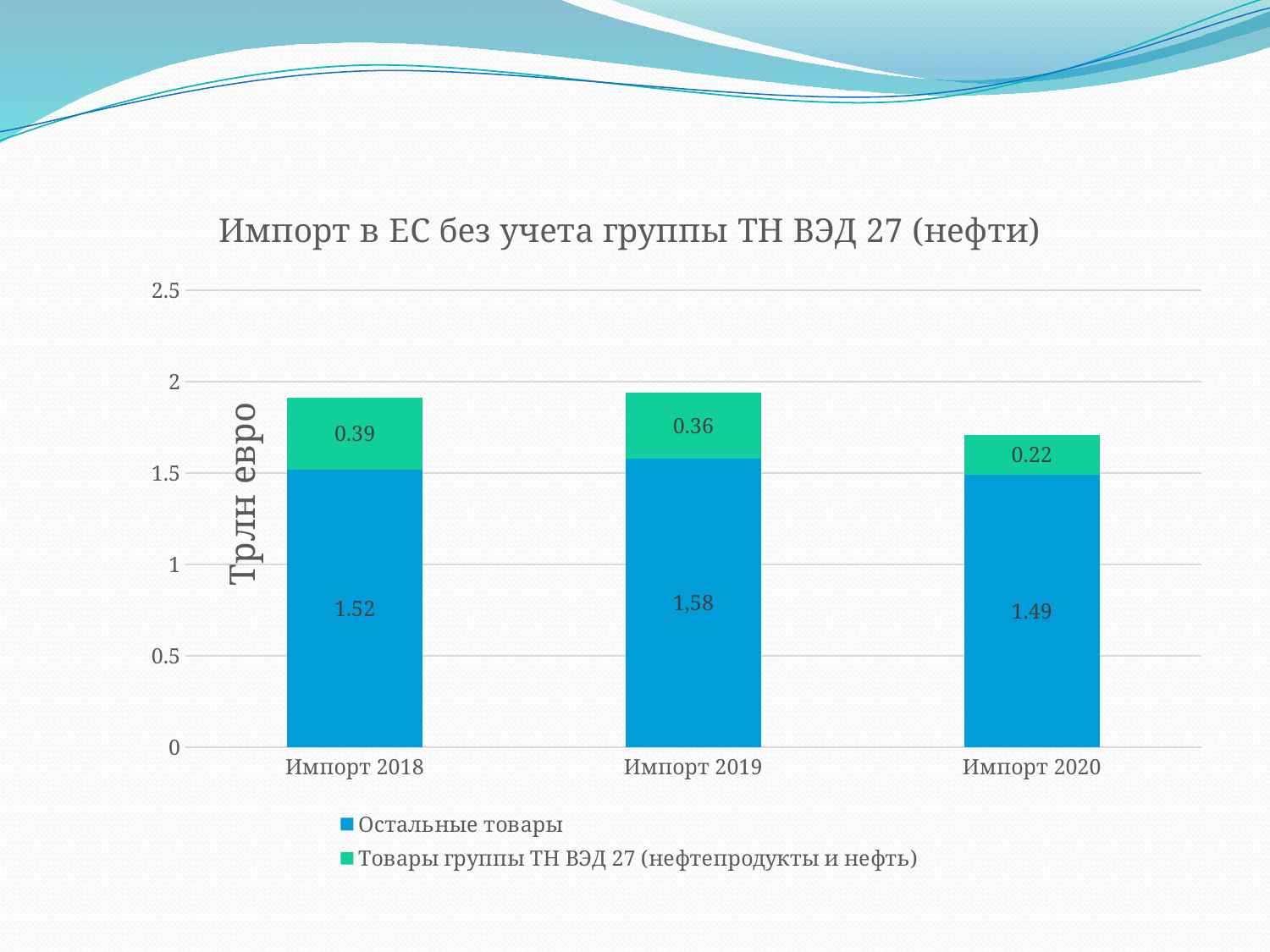
Which is larger: Остальные товары in Импорт 2019 or in Импорт 2020? Импорт 2019 What is the value for Товары группы ТН ВЭД 27 (нефтепродукты и нефть) in Импорт 2020? 0.22 What kind of chart is shown on the slide? Stacked bar chart What is the total of the stacked bar for Импорт 2020? 1.71 Which category has the lowest value for Остальные товары? Импорт 2020 How many series does the legend list? 2 What is the value for Остальные товары in Импорт 2019? 1,58 What is the value for Товары группы ТН ВЭД 27 (нефтепродукты и нефть) in Импорт 2018? 0.39 Which category has the highest value for Товары группы ТН ВЭД 27 (нефтепродукты и нефть)? Импорт 2018 What is the difference between the Товары группы ТН ВЭД 27 values for Импорт 2018 and Импорт 2020? 0.17 What is the value for Остальные товары in Импорт 2018? 1.52 How many categories are shown on the x axis? 3